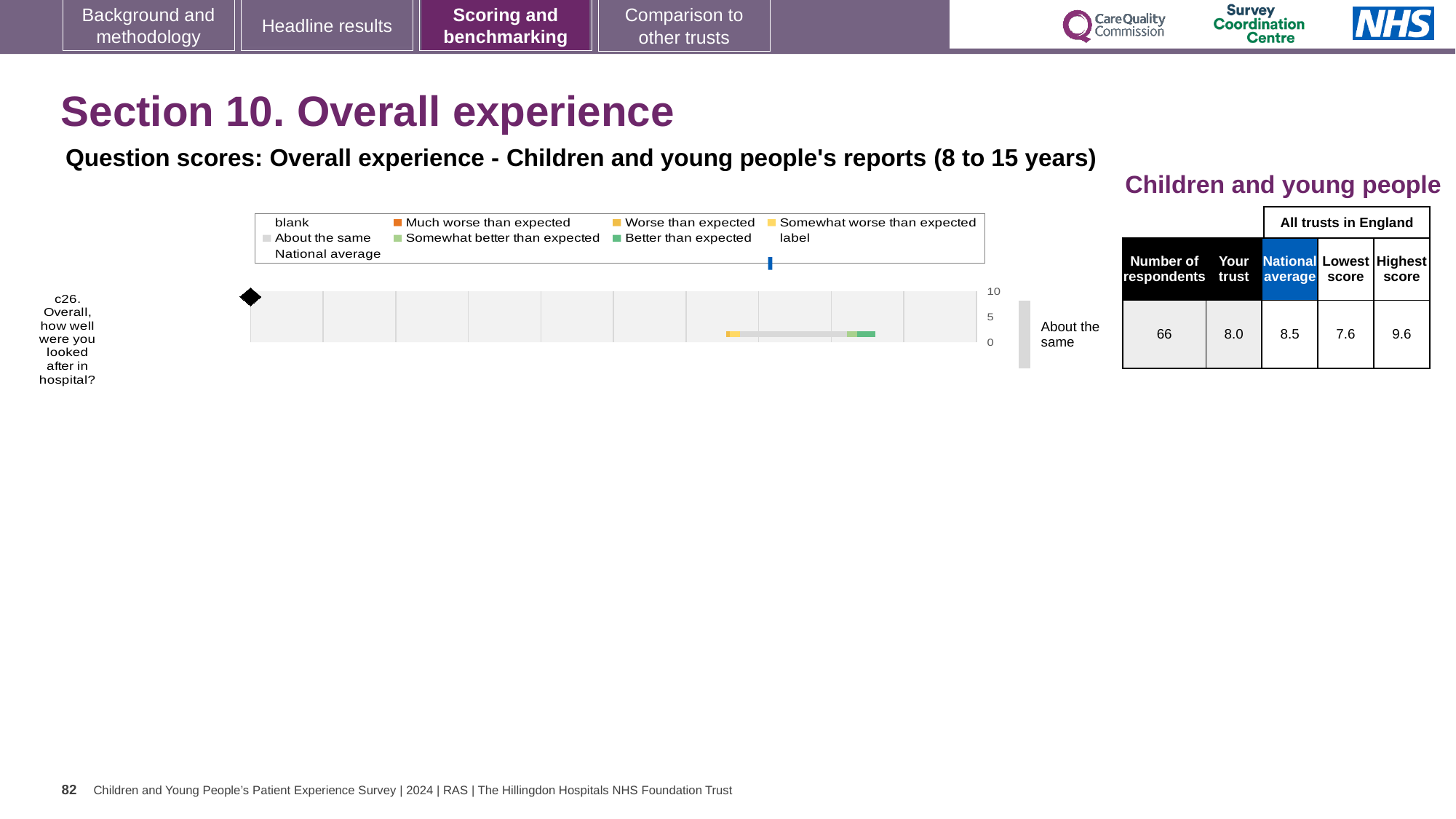
How many questions are plotted in the chart? 1 What benchmark category is the trust's result for c26 labelled as? About the same What is the 'Your trust' score for c26 'Overall, how well were you looked after in hospital?'? 8.0 What is the maximum value shown on the chart's score axis? 10 What is the highest score among all trusts in England for c26? 9.6 What is the lowest score among all trusts in England for c26? 7.6 What is the difference between the national average and the trust's score for c26? 0.5 What kind of chart is used to show the question score for c26? bar chart Which is larger for c26, the trust's score or the national average? National average What is the difference between the highest score and the lowest score for c26? 2.0 What is the national average score for c26? 8.5 How many respondents answered question c26? 66